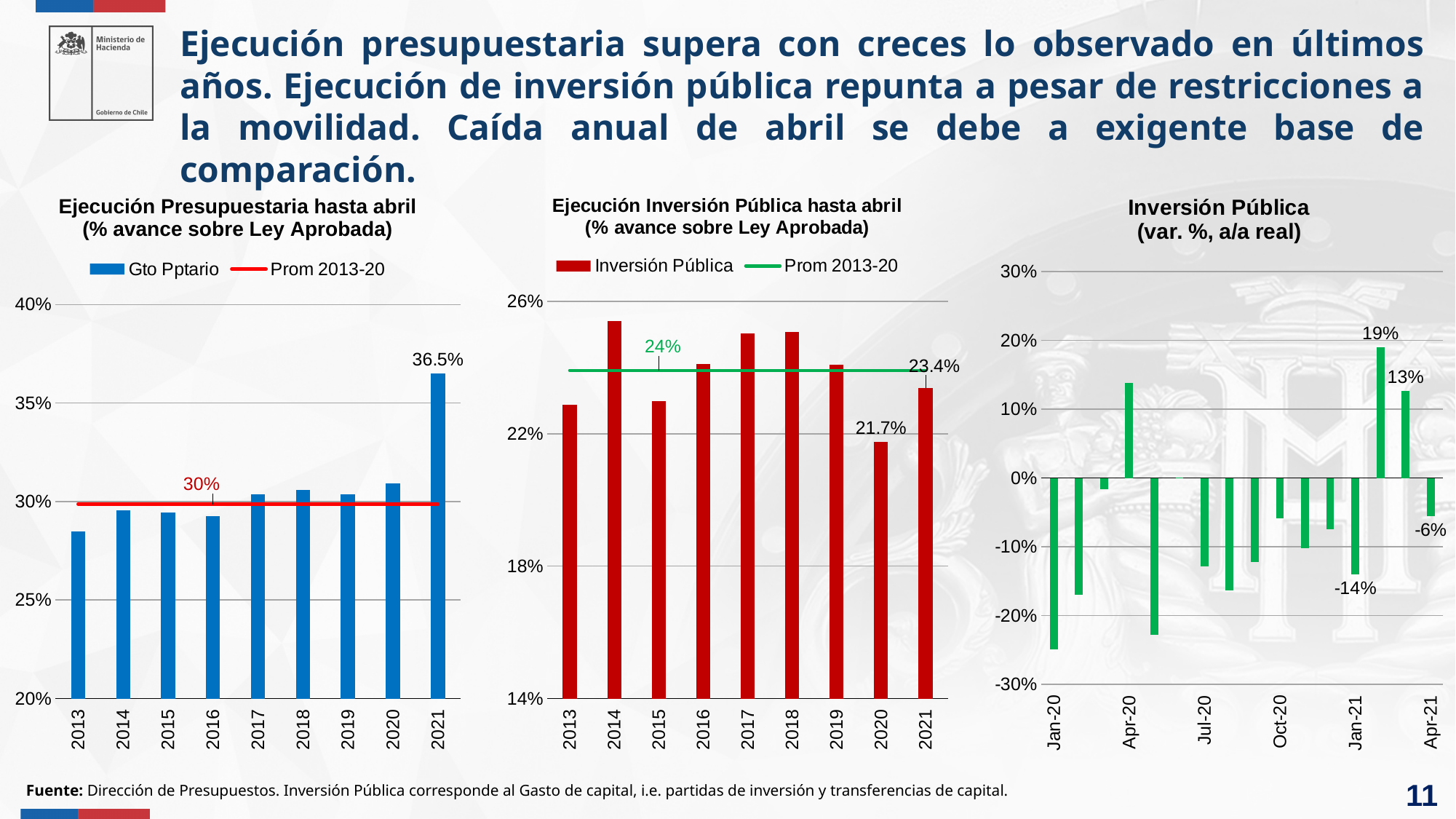
In the chart 'Ejecución Presupuestaria hasta abril', is the value for 2013 greater or less than 30%? less In the chart 'Inversión Pública (var. %, a/a real)', is the value for Jan-20 greater or less than -20%? less In the chart 'Ejecución Inversión Pública hasta abril', what is the difference between the 2021 value and the 2020 value? 1.7 percentage points In the chart 'Ejecución Presupuestaria hasta abril', what value is labelled on the Prom 2013-20 line? 30% In the chart 'Inversión Pública (var. %, a/a real)', what is the value for Apr-21? -6% In the chart 'Ejecución Inversión Pública hasta abril', what is the value for 2021? 23.4% What type of chart is 'Inversión Pública (var. %, a/a real)'? bar chart In the chart 'Ejecución Presupuestaria hasta abril', what is the value for 2021? 36.5% In the chart 'Ejecución Presupuestaria hasta abril', which year has the highest value? 2021 In the chart 'Ejecución Inversión Pública hasta abril', which year has the lowest value? 2020 In the chart 'Ejecución Presupuestaria hasta abril', how many entries does the legend list? 2 In the chart 'Ejecución Presupuestaria hasta abril', how many years are shown on the x axis? 9